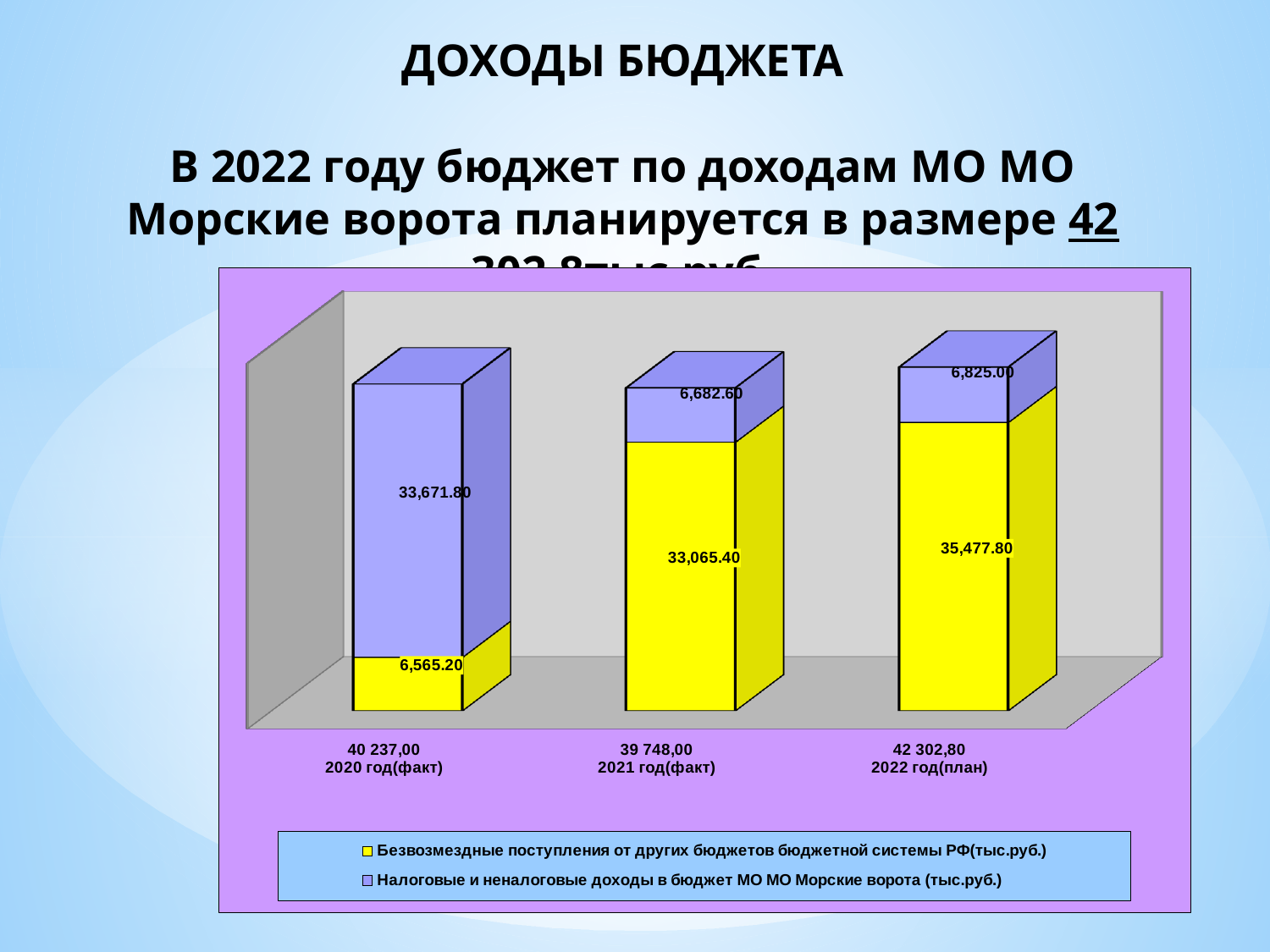
What is the value of Безвозмездные поступления от других бюджетов бюджетной системы РФ for 2020 год(факт)? 6,565.20 Which year has the highest total budget income shown in the chart? 2022 год(план) How many years (categories) are plotted in the chart? 3 What kind of chart is shown on the slide? stacked bar chart Which year has the lowest total budget income shown in the chart? 2021 год(факт) Which colour represents Безвозмездные поступления от других бюджетов бюджетной системы РФ in the legend? yellow What is the difference between Налоговые и неналоговые доходы in 2022 год(план) and in 2021 год(факт)? 142.40 What is the total of the stacked bar for 2022 год(план)? 42 302,80 How many series does the legend list? 2 What is the value of Безвозмездные поступления от других бюджетов бюджетной системы РФ for 2021 год(факт)? 33,065.40 What is the value of Налоговые и неналоговые доходы в бюджет МО МО Морские ворота for 2022 год(план)? 6,825.00 Which is larger: Налоговые и неналоговые доходы in 2020 год(факт) or in 2021 год(факт)? 2020 год(факт)